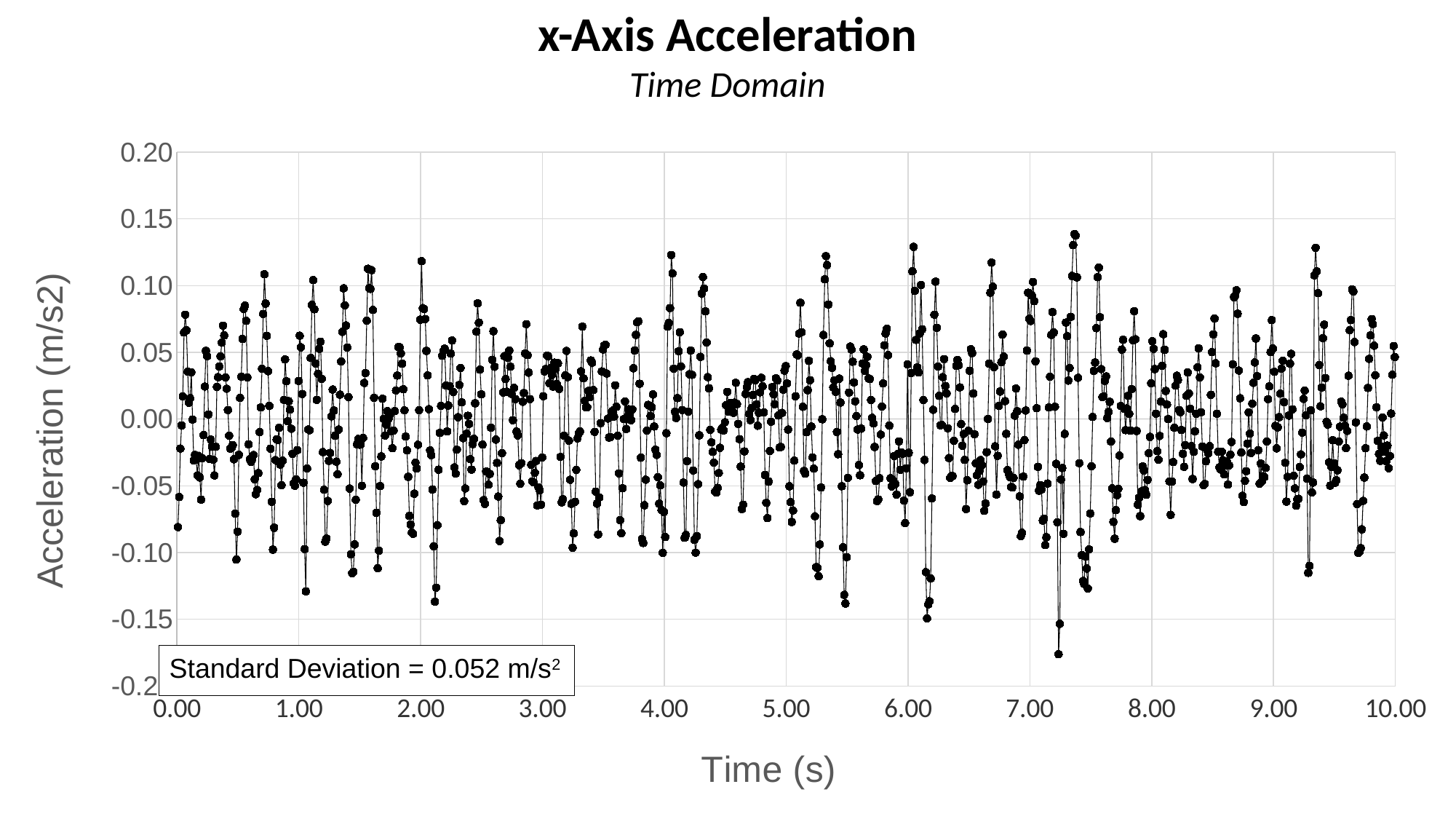
What standard deviation is stated in the text box on the chart? 0.052 m/s² Is the highest plotted acceleration value greater or less than 0.10? greater What is the title of the chart? x-Axis Acceleration What kind of chart is shown on the slide? line chart What is the largest time value shown on the x axis? 10.00 Is the lowest plotted acceleration value greater or less than -0.15? less What is the label of the y axis? Acceleration (m/s2) What is the highest value shown on the y axis? 0.20 How many data series are plotted on the chart? 1